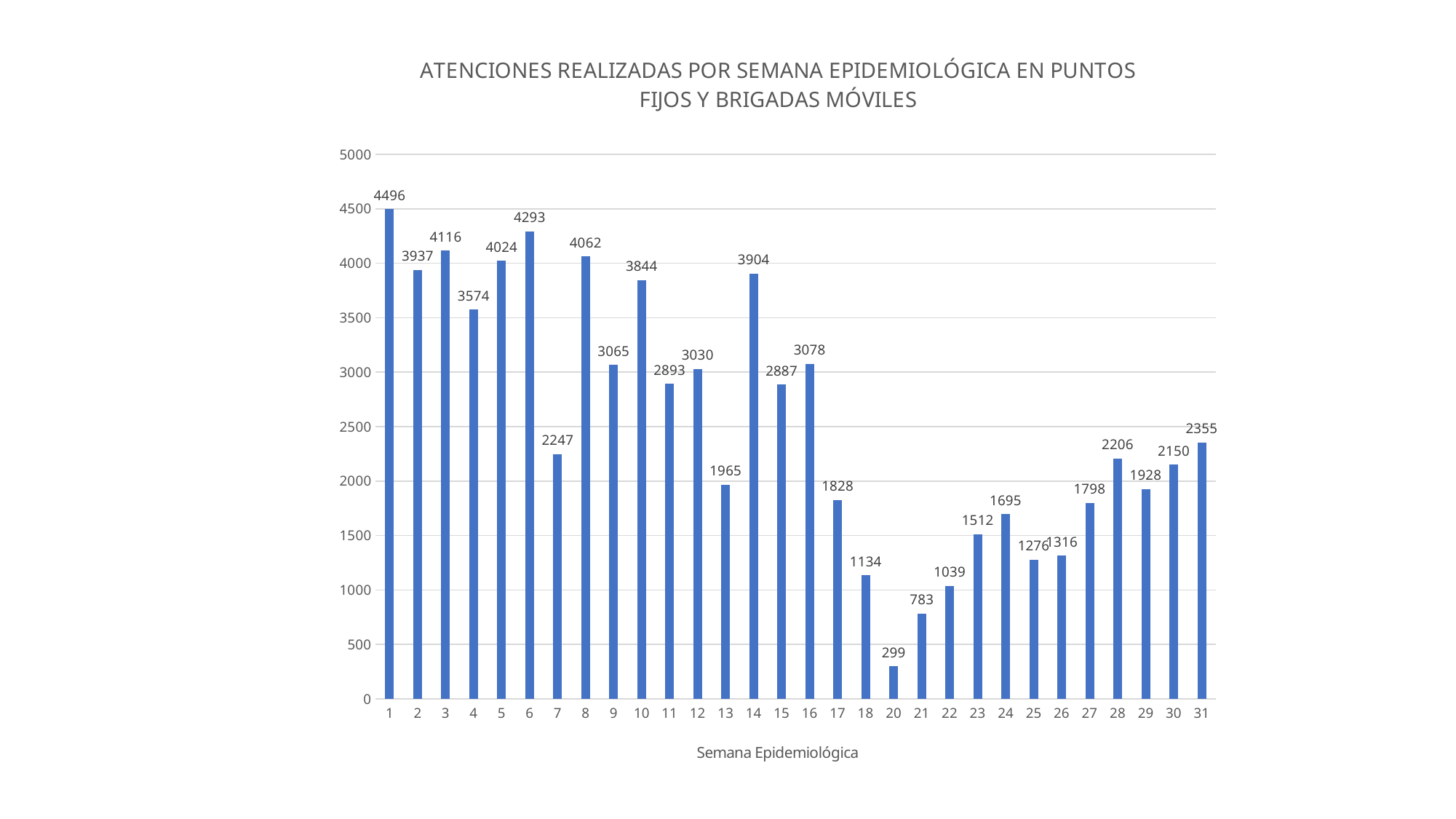
Which semana epidemiológica has the highest number of atenciones? 1 What is the difference between the values for semana 1 and semana 20? 4197 What is the value for semana epidemiológica 1? 4496 Which semana epidemiológica has the lowest number of atenciones? 20 What is the label of the x axis? Semana Epidemiológica Do the values generally rise or fall from semana 20 to semana 31? rise What type of chart is shown on the slide? bar chart What is the value for semana epidemiológica 20? 299 Which has a larger value, semana 7 or semana 13? semana 7 What is the difference between the values for semana 6 and semana 8? 231 How many semanas epidemiológicas are plotted on the chart? 30 What is the value for semana epidemiológica 14? 3904